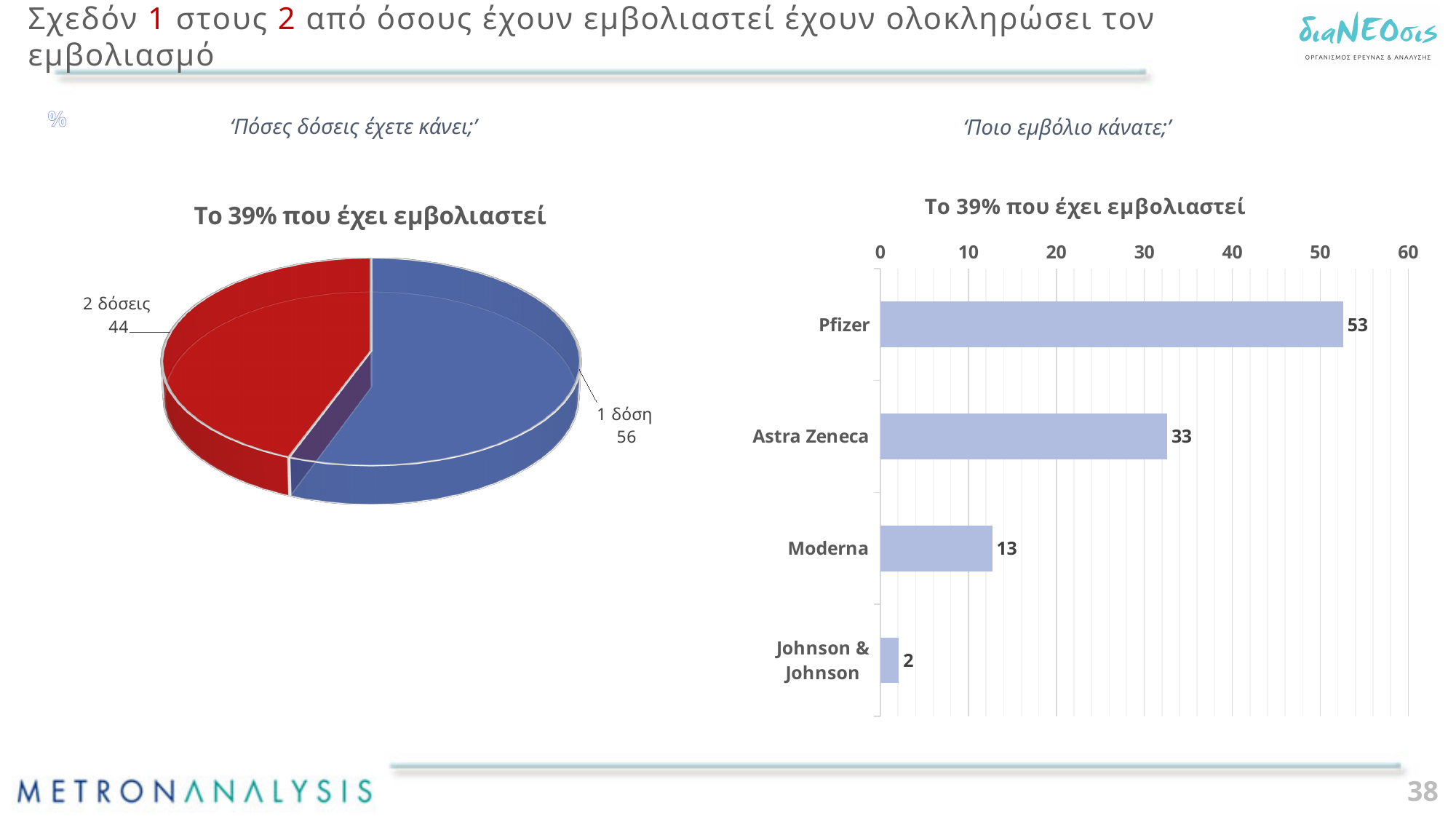
In the pie chart on the left, which slice is larger, '1 δόση' or '2 δόσεις'? 1 δόση In the pie chart on the left ('Πόσες δόσεις έχετε κάνει;'), what is the value for '1 δόση'? 56 In the pie chart on the left, what is the difference between the '1 δόση' and '2 δόσεις' values? 12 What kind of chart is shown on the right side of the slide? Bar chart In the bar chart on the right, which vaccine has the highest value? Pfizer In the bar chart on the right, which vaccine has the lowest value? Johnson & Johnson In the pie chart on the left ('Πόσες δόσεις έχετε κάνει;'), what is the value for '2 δόσεις'? 44 What kind of chart is shown on the left side of the slide? Pie chart In the bar chart on the right ('Ποιο εμβόλιο κάνατε;'), what is the value for Moderna? 13 In the bar chart on the right, what is the difference between the Pfizer and Astra Zeneca values? 20 In the bar chart on the right ('Ποιο εμβόλιο κάνατε;'), what is the value for Pfizer? 53 How many slices does the pie chart on the left have? 2